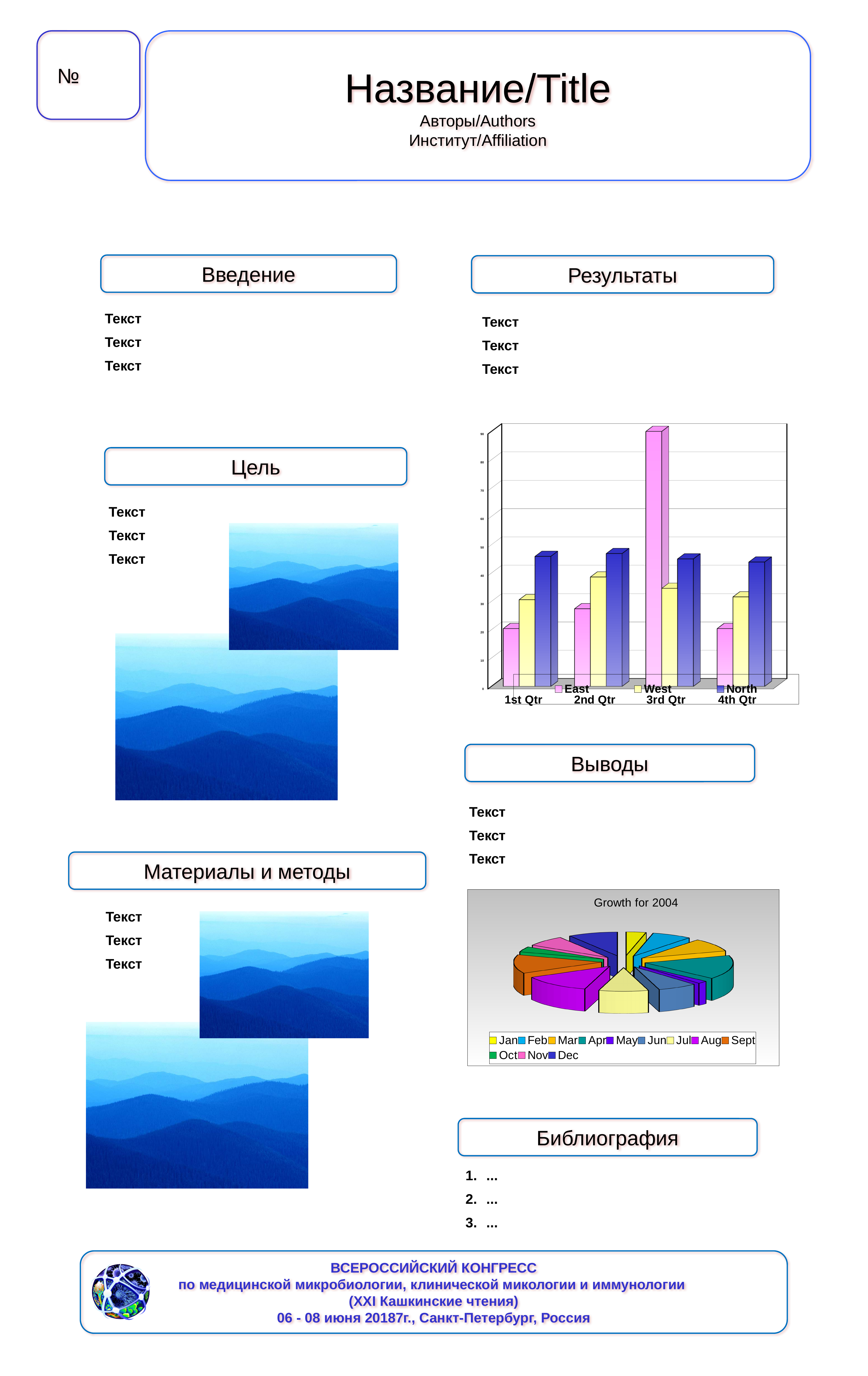
What type of chart is the chart in the Результаты section? bar chart In the bar chart in the Результаты section, is the East value for 3rd Qtr greater or less than 80? greater In the bar chart in the Результаты section, is the North value for 1st Qtr greater or less than 40? greater What is the title of the pie chart on the slide? Growth for 2004 In the bar chart in the Результаты section, is the East value for 1st Qtr greater or less than 30? less In the bar chart in the Результаты section, in which quarter is the East series highest? 3rd Qtr In the bar chart in the Результаты section, how many quarter categories are shown on the x axis? 4 In the bar chart in the Результаты section, how many series does the legend list? 3 In the chart titled Growth for 2004, how many entries does the legend list? 12 In the bar chart in the Результаты section, which is larger in 3rd Qtr: East or West? East What type of chart is the chart titled Growth for 2004? pie chart In the bar chart in the Результаты section, which is larger in 1st Qtr: West or North? North